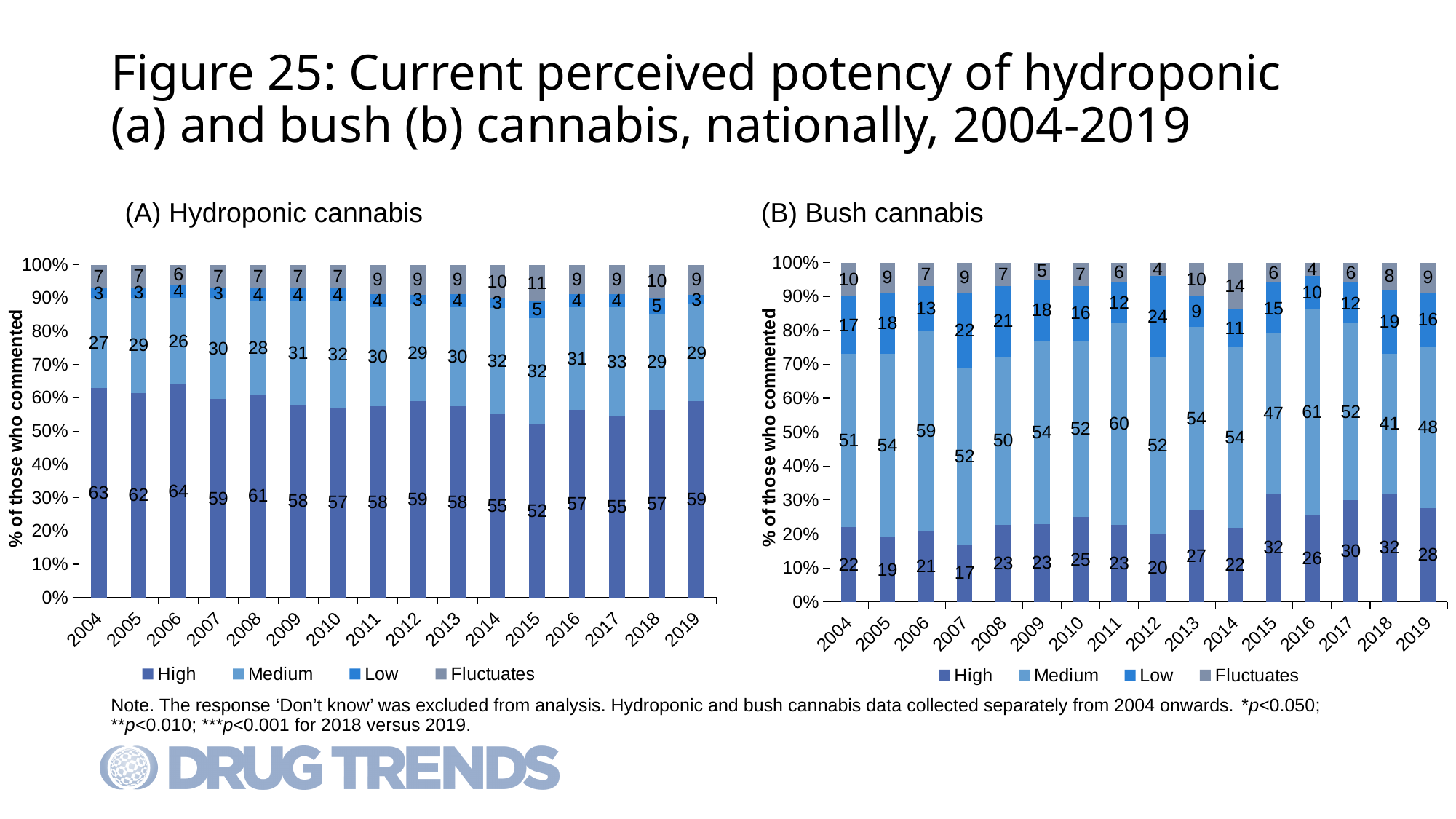
In the (A) Hydroponic cannabis chart, which year has the lowest value for High? 2015 In the (A) Hydroponic cannabis chart, what is the difference between the Medium values for 2017 and 2004? 6 In the (B) Bush cannabis chart, which is larger: the Fluctuates value for 2014 or for 2013? 2014 How many years are shown on the x axis of the (A) Hydroponic cannabis chart? 16 What kind of chart is the (A) Hydroponic cannabis chart? Stacked bar chart In the (A) Hydroponic cannabis chart, which year has the highest value for High? 2006 In the (B) Bush cannabis chart, what is the difference between the High values for 2018 and 2019? 4 In the (A) Hydroponic cannabis chart, what is the value for High in 2004? 63 How many series does the legend of the (B) Bush cannabis chart list? 4 In the (B) Bush cannabis chart, what is the value for Medium in 2016? 61 In the (B) Bush cannabis chart, what is the value for Low in 2012? 24 In the (B) Bush cannabis chart, which year has the lowest value for High? 2007